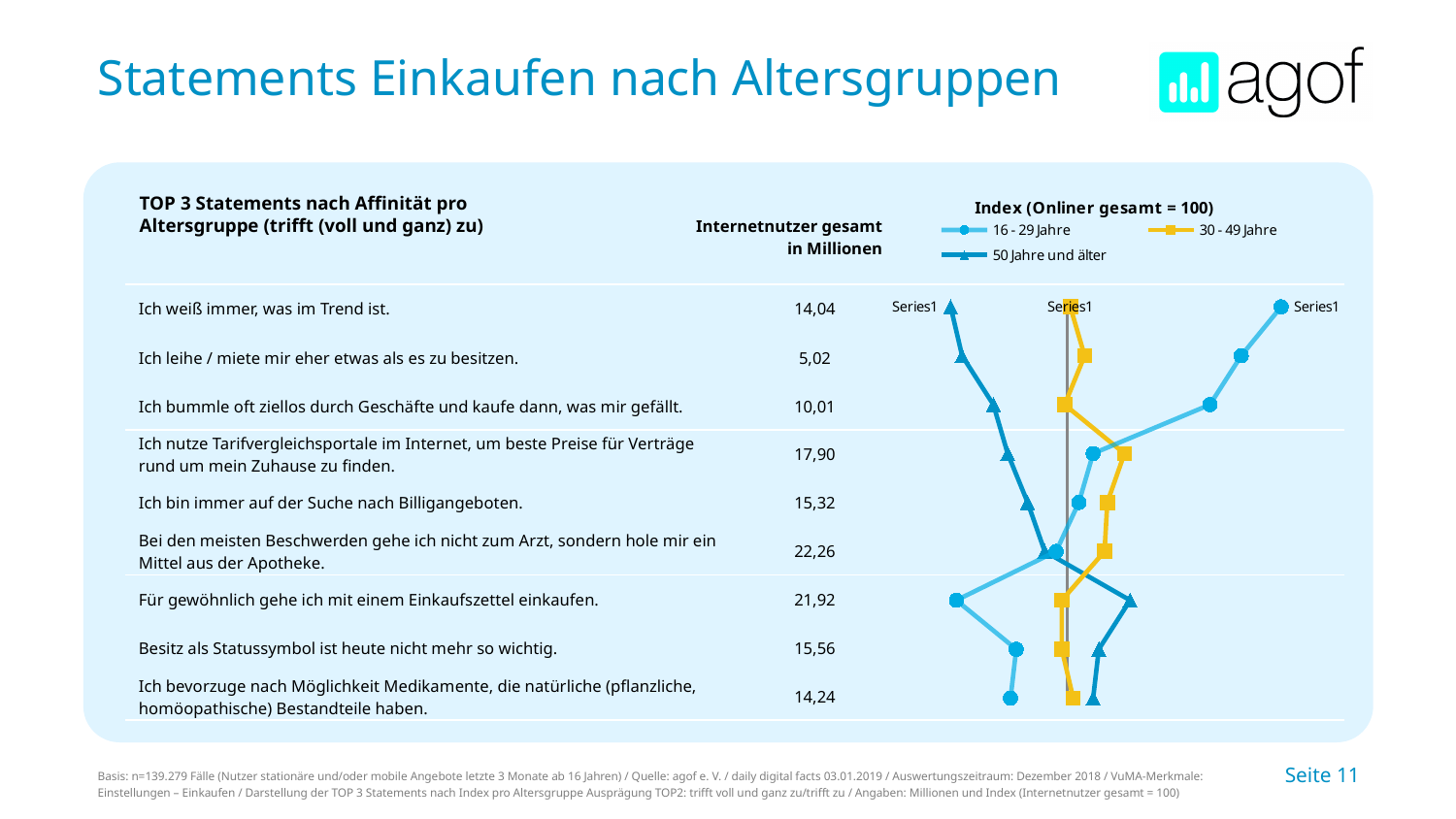
For the statement 'Ich leihe / miete mir eher etwas als es zu besitzen', is the index for 16 - 29 Jahre larger or smaller than the index for 50 Jahre und älter? larger What kind of chart is shown on the slide? line chart For the statement 'Ich weiß immer, was im Trend ist', which age group has the lowest index? 50 Jahre und älter For the statement 'Ich weiß immer, was im Trend ist', is the index for 50 Jahre und älter greater or less than 100? less For the statement 'Für gewöhnlich gehe ich mit einem Einkaufszettel einkaufen', is the index for 16 - 29 Jahre greater or less than 100? less How many series does the chart legend list? 3 How many statements are plotted in the chart? 9 For the statement 'Für gewöhnlich gehe ich mit einem Einkaufszettel einkaufen', which age group has the highest index? 50 Jahre und älter What is the value in 'Internetnutzer gesamt in Millionen' for the statement 'Bei den meisten Beschwerden gehe ich nicht zum Arzt, sondern hole mir ein Mittel aus der Apotheke'? 22,26 Which age groups are listed in the chart legend? 16 - 29 Jahre, 30 - 49 Jahre, 50 Jahre und älter What is the reference value of the index according to the chart legend title? Onliner gesamt = 100 For the statement 'Ich weiß immer, was im Trend ist', which age group has the highest index? 16 - 29 Jahre